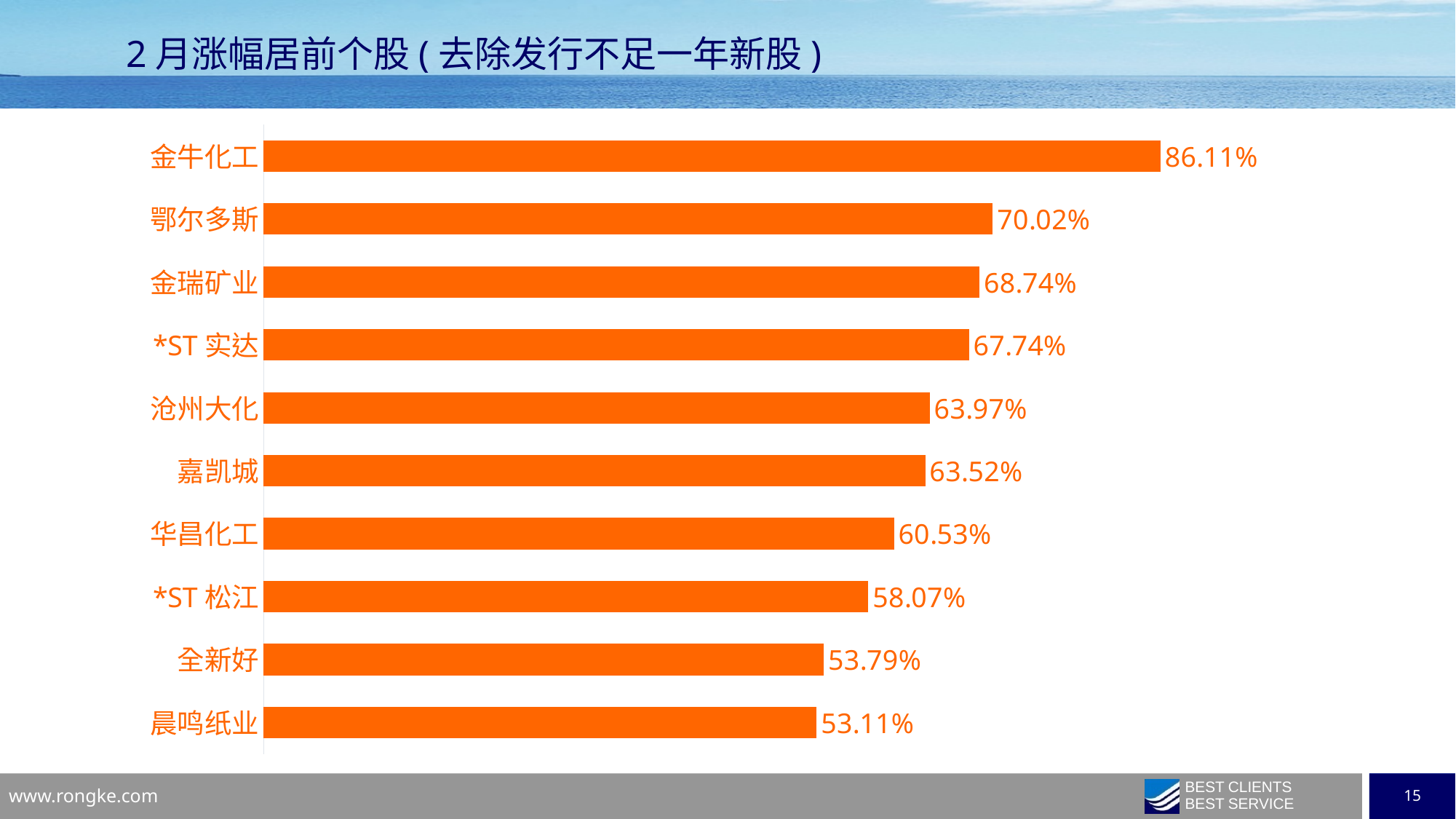
What is the difference between the values for 金牛化工 and 鄂尔多斯? 16.09% Which stock has the highest value? 金牛化工 What is the difference between the values for 华昌化工 and 全新好? 6.74% What is the value for 金牛化工? 86.11% What is the value for *ST 松江? 58.07% Which stock has the lowest value? 晨鸣纸业 Which is larger, the value for 金瑞矿业 or the value for 嘉凯城? 金瑞矿业 How many stocks are shown in the chart? 10 What is the value for 沧州大化? 63.97% What kind of chart is shown on the slide? Bar chart What is the value for 晨鸣纸业? 53.11% What is the title of the slide? 2 月涨幅居前个股（去除发行不足一年新股）